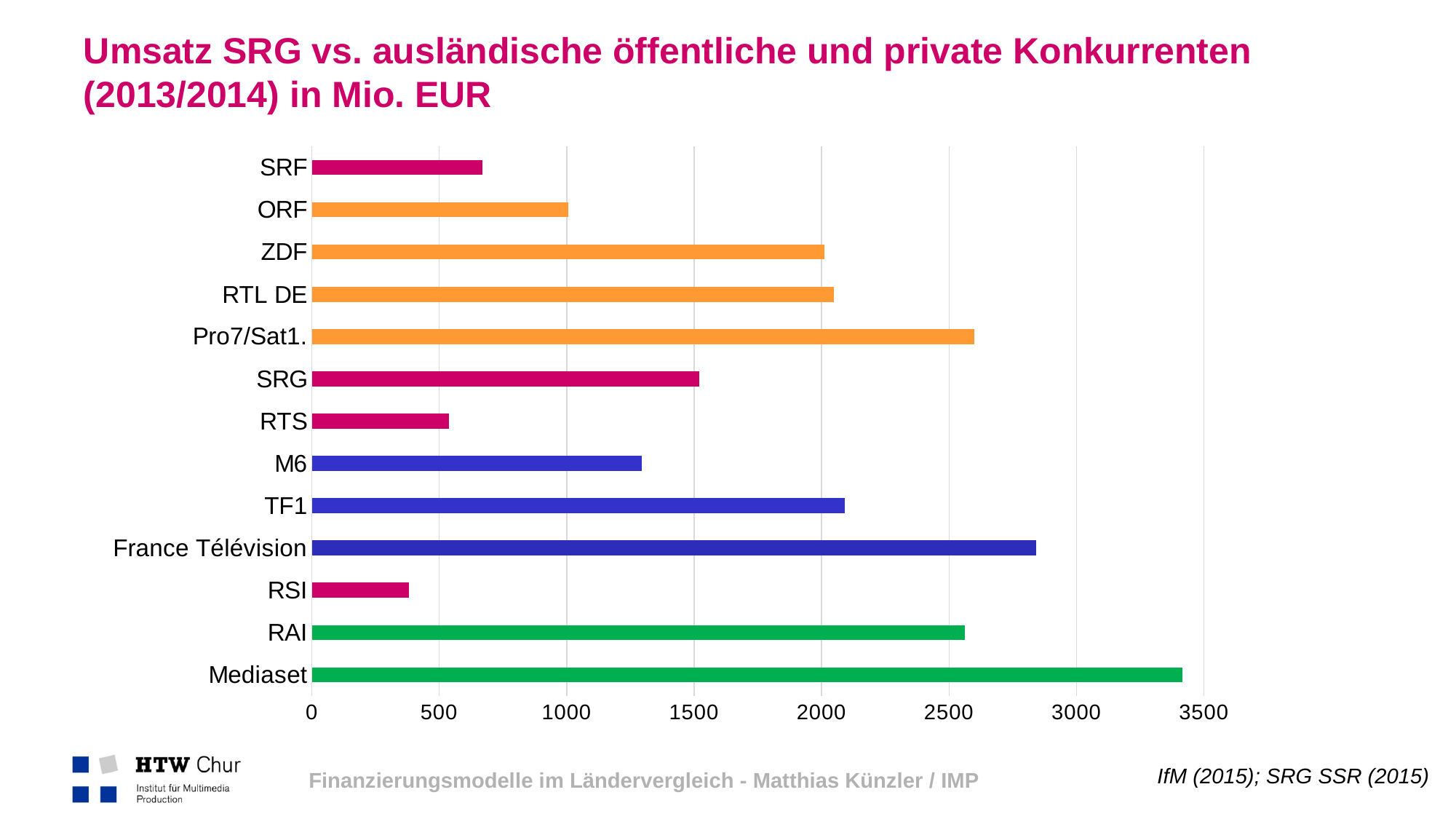
Is the value for SRF greater or less than 1000? less Is the value for M6 greater or less than 1000? greater Is the value for RSI greater or less than 500? less Which broadcaster has the lowest revenue in the chart? RSI Which has the larger value, SRG or M6? SRG What is the title of the chart on the slide? Umsatz SRG vs. ausländische öffentliche und private Konkurrenten (2013/2014) in Mio. EUR How many broadcasters (categories) are shown in the chart? 13 Which has the larger value, France Télévision or TF1? France Télévision What kind of chart is shown on the slide? bar chart Which broadcaster has the highest revenue in the chart? Mediaset